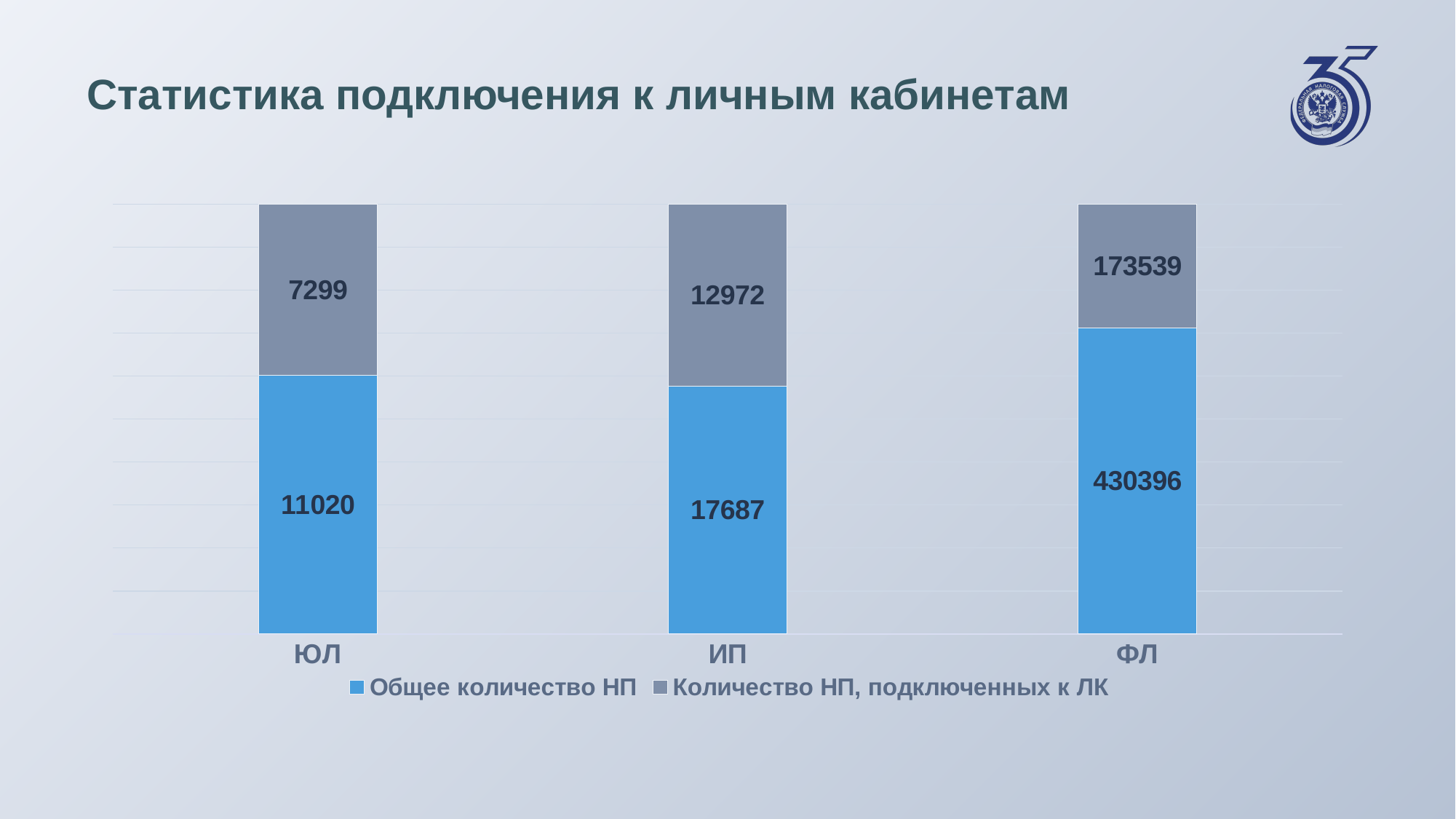
What is the value of "Общее количество НП" for ЮЛ? 11020 What is the value of "Количество НП, подключенных к ЛК" for ФЛ? 173539 How many series does the legend list? 2 How many categories are shown on the x axis? 3 What is the total of the two values shown for the ИП bar? 30659 What is the value of "Количество НП, подключенных к ЛК" for ИП? 12972 What is the difference between "Общее количество НП" and "Количество НП, подключенных к ЛК" for ФЛ? 256857 Which category has the highest value for "Общее количество НП"? ФЛ Which category has the lowest value for "Количество НП, подключенных к ЛК"? ЮЛ What is the difference between "Общее количество НП" and "Количество НП, подключенных к ЛК" for ЮЛ? 3721 Which is larger: "Общее количество НП" for ИП or for ЮЛ? ИП What kind of chart is shown on the slide? Stacked bar chart